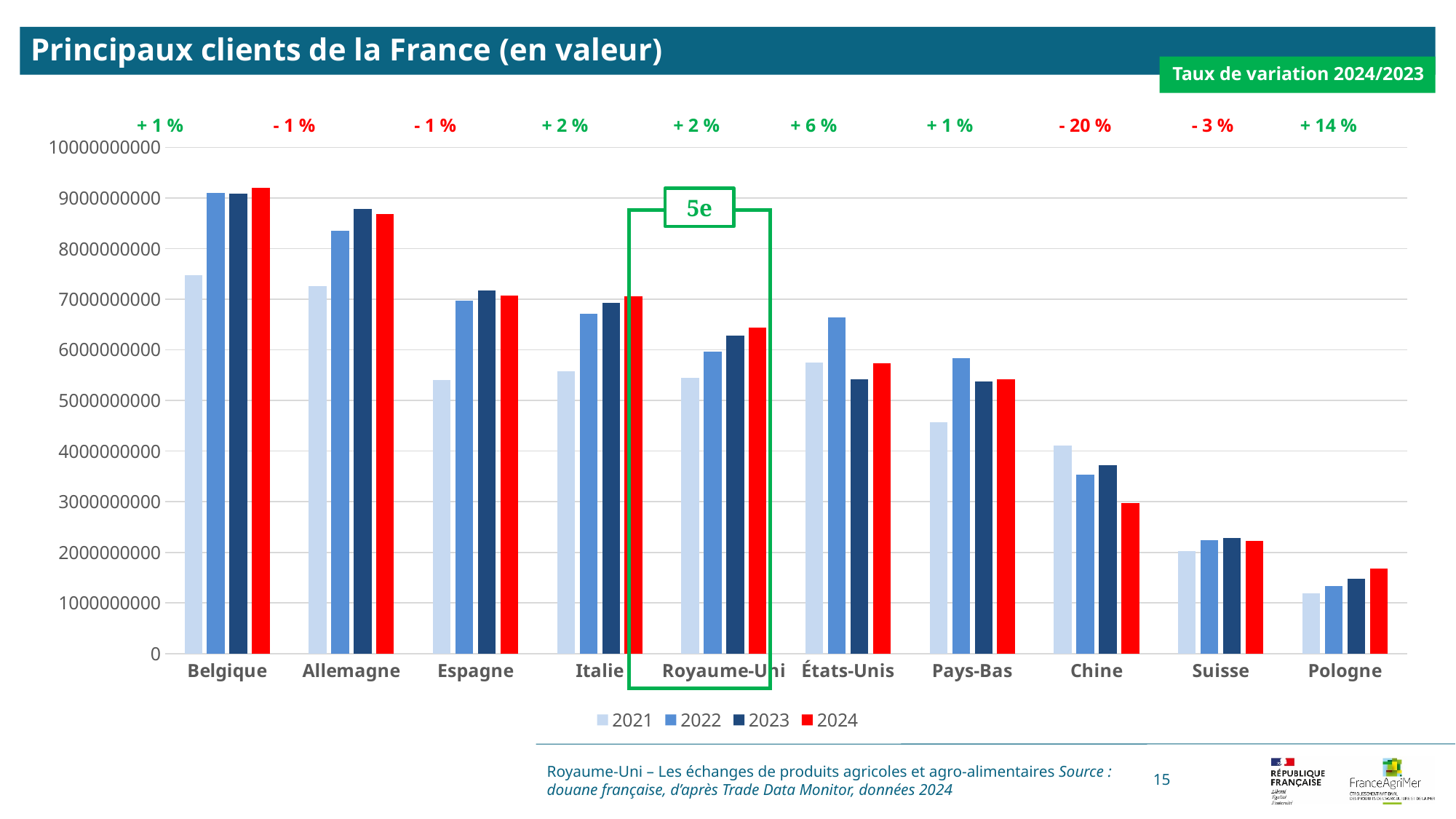
Which country has the highest 2024/2023 variation rate? Pologne How many series does the legend list? 4 Is the 2024 value for Belgique greater or less than 9000000000? greater What is the 2024/2023 variation rate shown above Chine? - 20 % How many countries are shown on the x axis of the chart? 10 For Chine, which is larger: the 2021 value or the 2024 value? 2021 Which country has the lowest 2024 bar? Pologne What is the 2024/2023 variation rate shown above Pologne? + 14 % Which country is marked with the '5e' annotation on the chart? Royaume-Uni Is the 2024 value for Royaume-Uni greater or less than 6000000000? greater What kind of chart is shown on the slide? bar chart Which country has the highest 2024 bar? Belgique